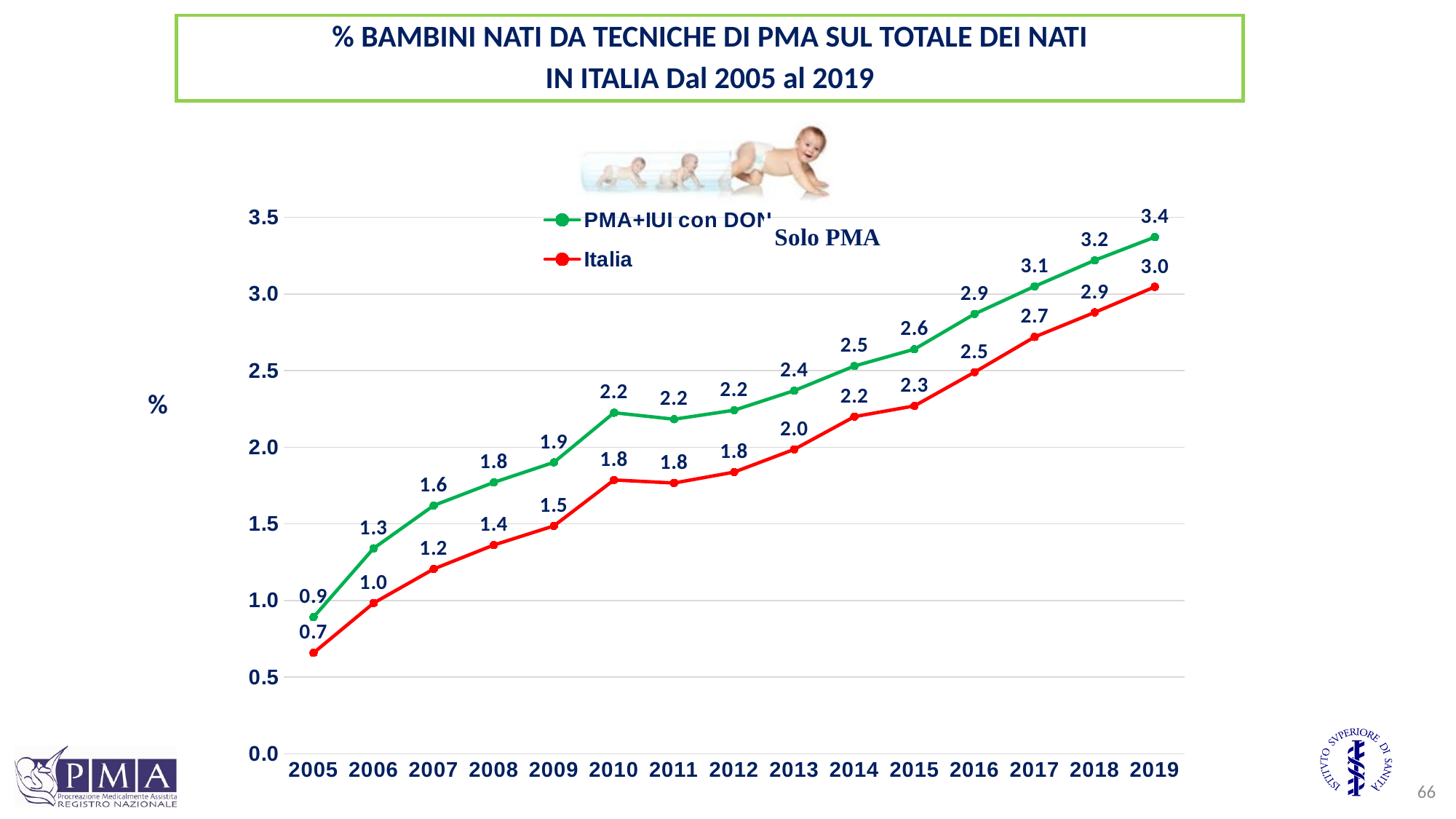
In which year is the green (upper) line at its highest? 2019 What is the difference between the green line and Italia in 2019? 0.4 Which is larger in 2015: the green line or Italia? the green line What is the value of the green (upper) line in 2010? 2.2 What is the value of the green (upper) line in 2019? 3.4 Does the Italia series generally rise or fall from 2005 to 2019? rise How many series does the legend list? 2 What is the value for Italia in 2005? 0.7 How many years are shown on the x axis? 15 In which year is the Italia series at its lowest? 2005 What is the value for Italia in 2019? 3.0 What type of chart is shown on the slide? line chart